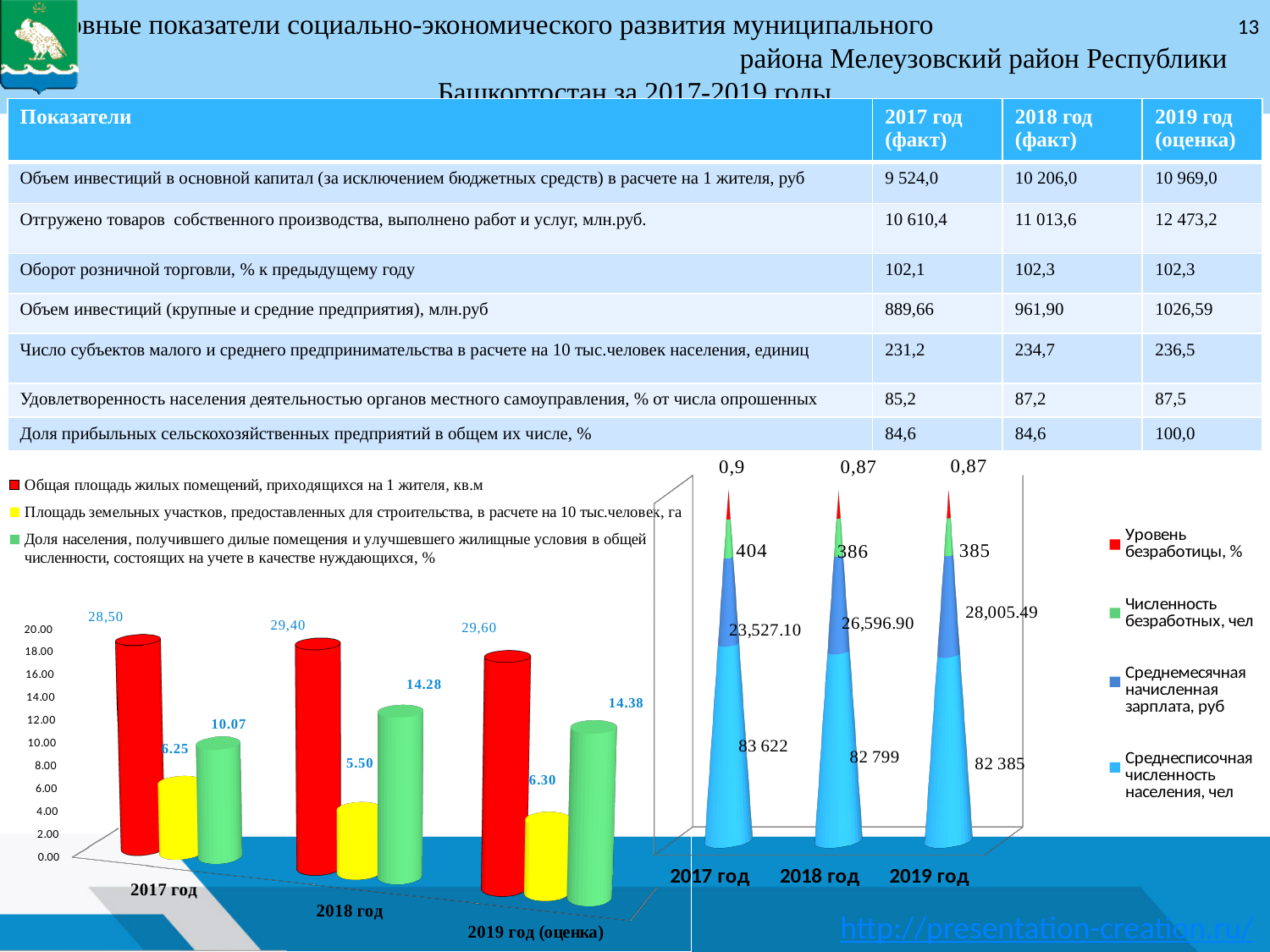
On the left chart, what is the value of the red series (Общая площадь жилых помещений, приходящихся на 1 жителя, кв.м) for 2017 год? 28,50 On the left chart, does the green series (Доля населения...) rise or fall from 2017 год to 2019 год (оценка)? rise On the right chart, does Среднесписочная численность населения, чел rise or fall from 2017 год to 2019 год? fall On the right chart, what is the value of Численность безработных, чел for 2018 год? 386 On the right chart, what is the value of Среднемесячная начисленная зарплата, руб for 2019 год? 28,005.49 On the left chart, what is the value of the green series (Доля населения, получившего жилые помещения...) for 2018 год? 14.28 On the left chart, how many series does the legend list? 3 On the right chart, what is the value of Среднесписочная численность населения, чел for 2017 год? 83 622 On the left chart, what is the value of the yellow series (Площадь земельных участков...) for 2019 год (оценка)? 6.30 On the left chart, what is the difference between the red series values for 2019 год (оценка) and 2017 год? 1,10 On the right chart, how many series does the legend list? 4 On the left chart, in which year is the yellow series (Площадь земельных участков...) lowest? 2018 год